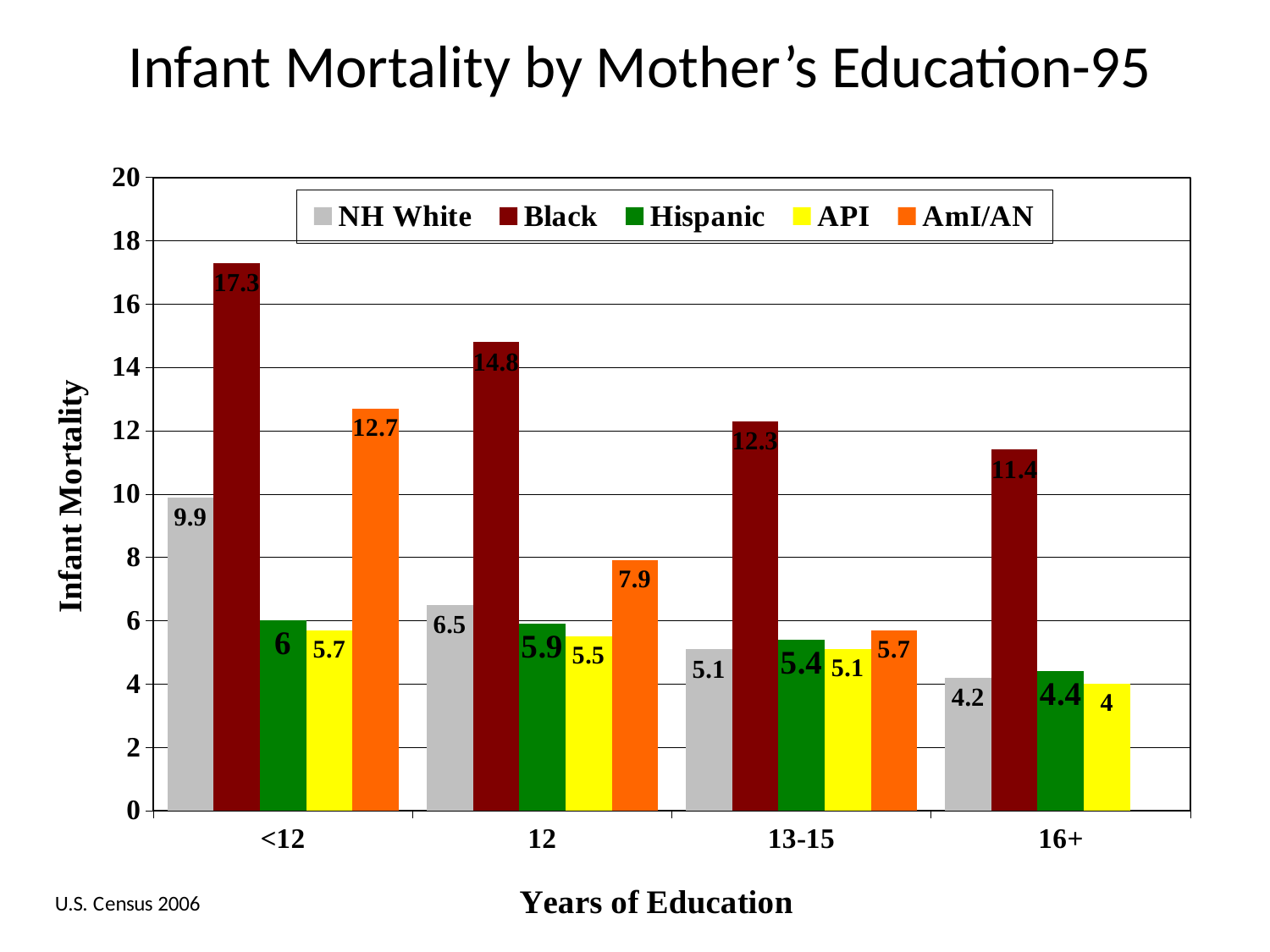
How many series does the legend list? 5 Do the infant mortality values for NH White mothers rise or fall as years of education increase? Fall Which series has the lowest infant mortality in the 16+ years of education group? API How many education categories are shown on the x axis? 4 What is the difference between the Black and NH White infant mortality values in the 13-15 years of education group? 7.2 What kind of chart is shown on the slide? Bar chart Which is larger, the AmI/AN value for <12 years of education or the Black value for 16+ years of education? AmI/AN value for <12 What is the label of the y axis? Infant Mortality What is the infant mortality value for NH White mothers with 16+ years of education? 4.2 Which education group has the highest infant mortality for Black mothers? <12 What is the infant mortality value for AmI/AN mothers with 12 years of education? 7.9 What is the infant mortality value for Black mothers with less than 12 years of education? 17.3